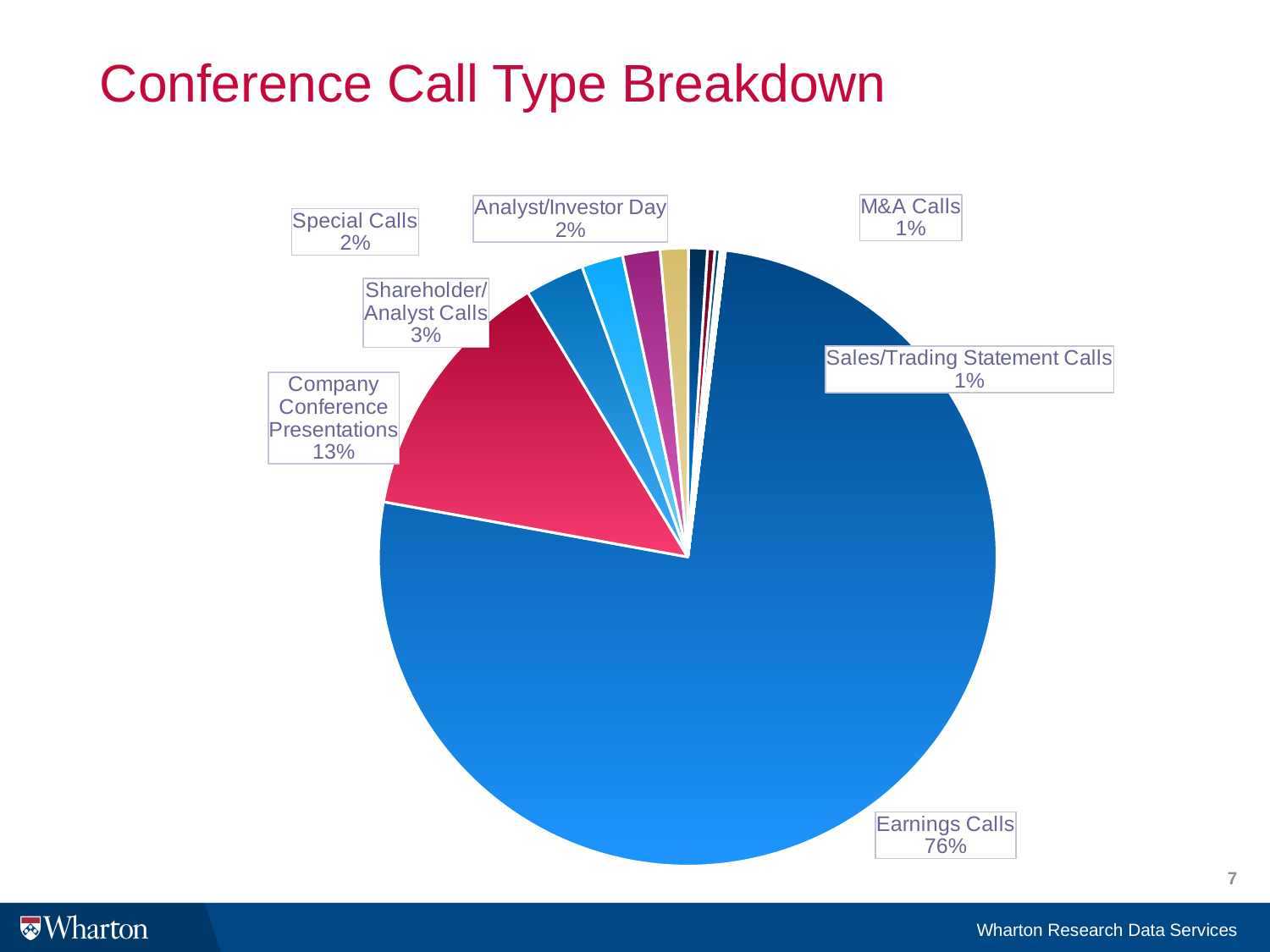
Which conference call type has the largest share of the pie? Earnings Calls What share of the pie do Earnings Calls represent? 76% What percentage is shown for Shareholder/Analyst Calls? 3% What is the title of the chart? Conference Call Type Breakdown What percentage is shown for Company Conference Presentations? 13% What percentage is shown for Special Calls? 2% What percentage is shown for Sales/Trading Statement Calls? 1% Which has a larger share: Company Conference Presentations or Shareholder/Analyst Calls? Company Conference Presentations What percentage is shown for M&A Calls? 1% What type of chart is shown on the slide? Pie chart What percentage is shown for Analyst/Investor Day? 2% What is the difference in percentage points between Earnings Calls and Company Conference Presentations? 63 percentage points